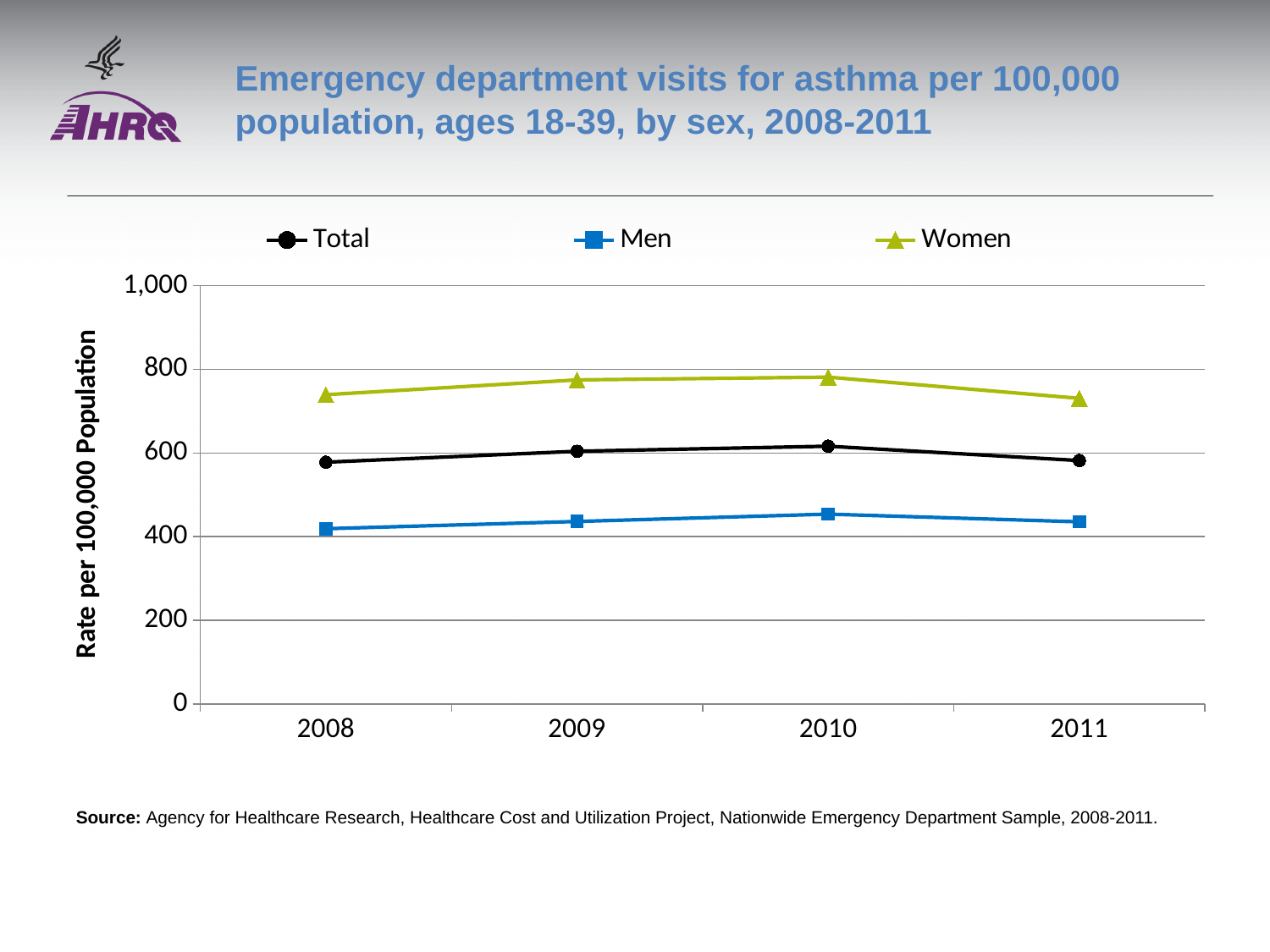
In which year is the rate for Men highest? 2010 Which series has the highest values across all years? Women Is the value for Men in 2010 greater or less than 600? less Does the rate for Men rise or fall from 2008 to 2010? rise In 2009, which is larger: the rate for Women or the rate for Men? Women Is the value for Total in 2008 greater or less than 600? less Is the value for Women in 2008 greater or less than 800? less What kind of chart is shown on the slide? Line chart How many years are plotted along the x axis? 4 What is the label on the y axis? Rate per 100,000 Population How many series does the legend list? 3